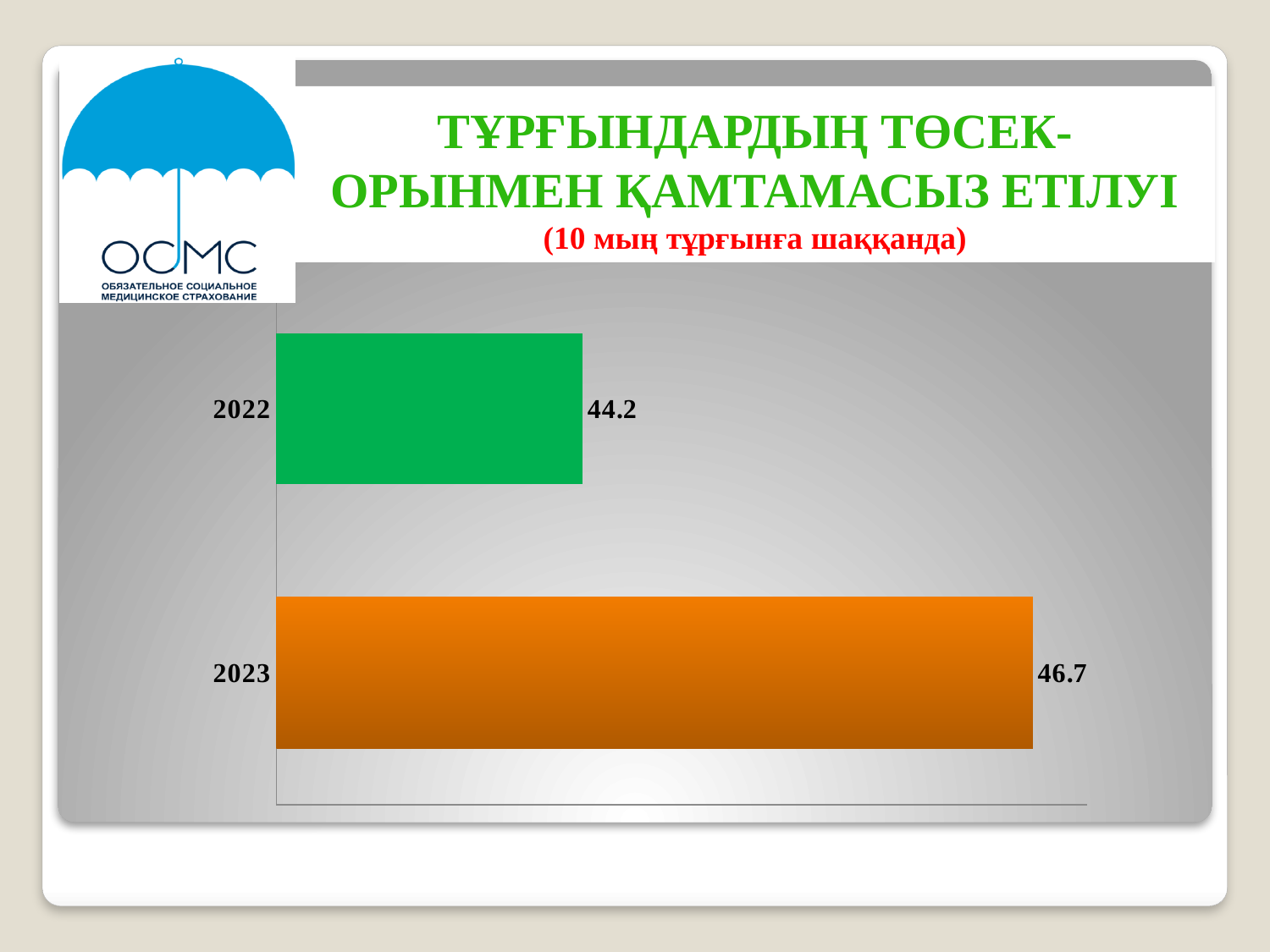
What kind of chart is shown on the slide? bar chart What is the difference between the values for 2023 and 2022? 2.5 How many categories are shown in the chart? 2 Which year has the lower value? 2022 Which year has the higher value? 2023 Does the value rise or fall from 2022 to 2023? rise What is the value for 2022? 44.2 Is the value for 2023 larger or smaller than the value for 2022? larger What colour is the bar for 2022? green What is the value for 2023? 46.7 What colour is the bar for 2023? orange